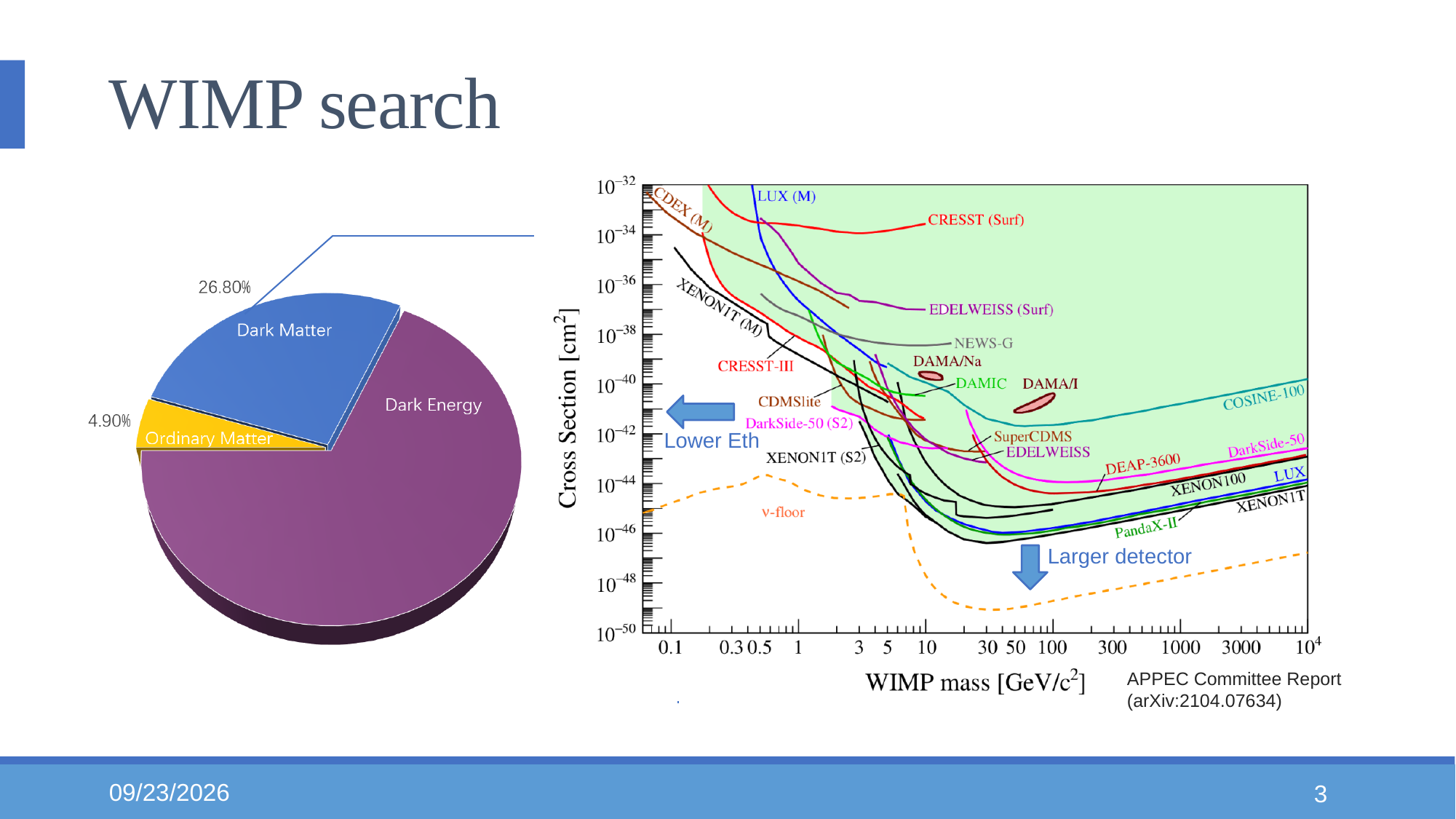
In the pie chart on the left, which is larger, Dark Matter or Ordinary Matter? Dark Matter In the pie chart on the left, which slice is the smallest? Ordinary Matter In the pie chart on the left, which slice is the largest? Dark Energy In the pie chart on the left, what percentage is shown for Ordinary Matter? 4.90% In the pie chart on the left, what percentage is shown for Dark Matter? 26.80% What is the x-axis label of the chart on the right of the slide? WIMP mass [GeV/c2] What is the y-axis label of the chart on the right of the slide? Cross Section [cm2] In the pie chart on the left, is the Dark Matter share greater or less than 25%? greater What kind of chart is the chart on the right of the slide? Line chart In the pie chart on the left, what is the difference between the Dark Matter and Ordinary Matter percentages? 21.90% In the pie chart on the left, how many slices are there? 3 What kind of chart is the chart on the left of the slide? Pie chart